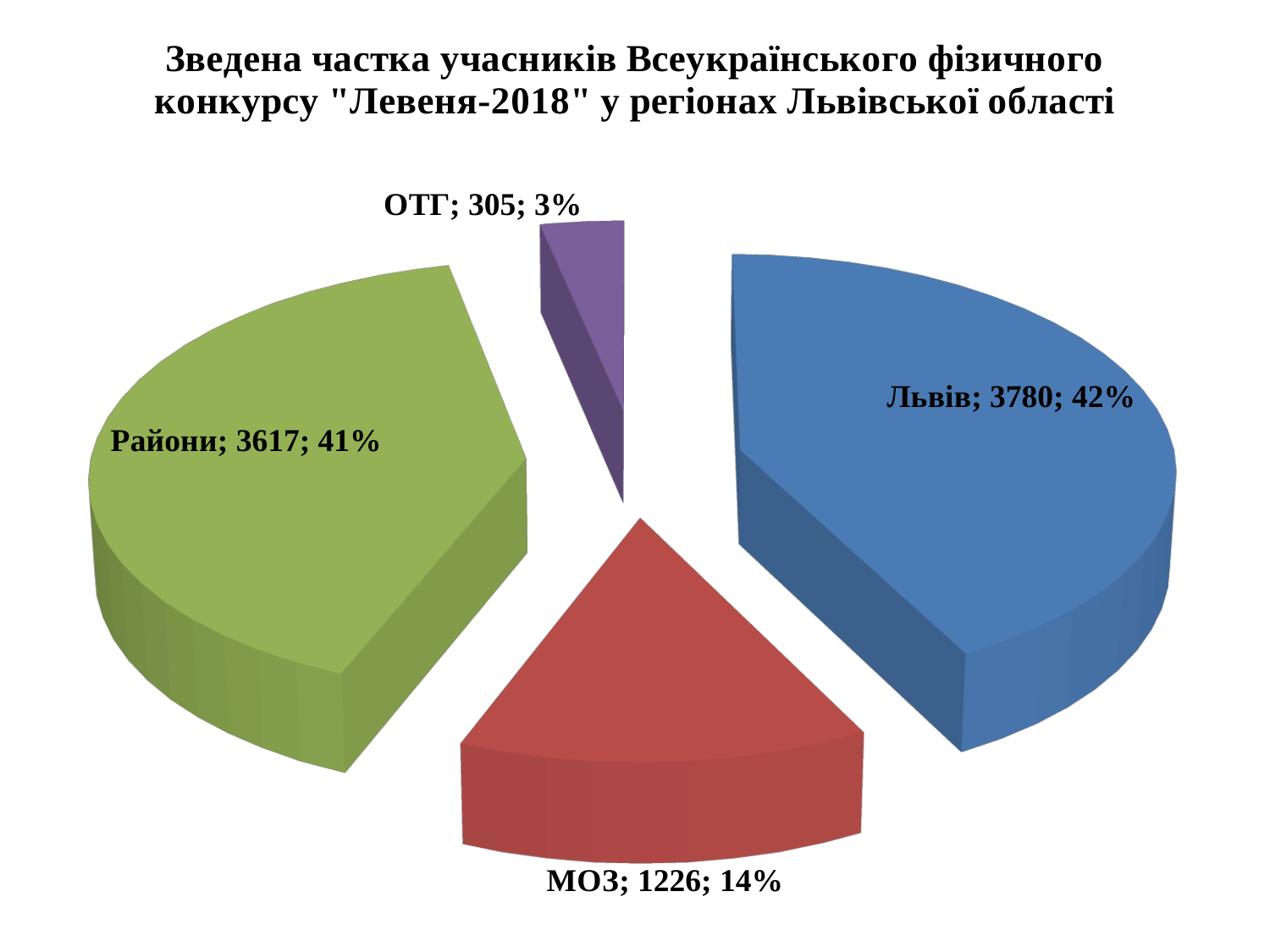
What share of the pie does the Райони slice have? 41% What is the value shown for МОЗ? 1226 Which category has the smallest slice of the pie? ОТГ What percentage is shown for ОТГ? 3% What is the difference between the values for Львів and Райони? 163 What colour is the Львів slice? blue Which category has the largest slice of the pie? Львів How many participants does the Львів slice represent? 3780 Which has a larger value, Райони or МОЗ? Райони What is the difference between the values for МОЗ and ОТГ? 921 What type of chart is shown on the slide? pie chart How many slices does the pie chart have? 4